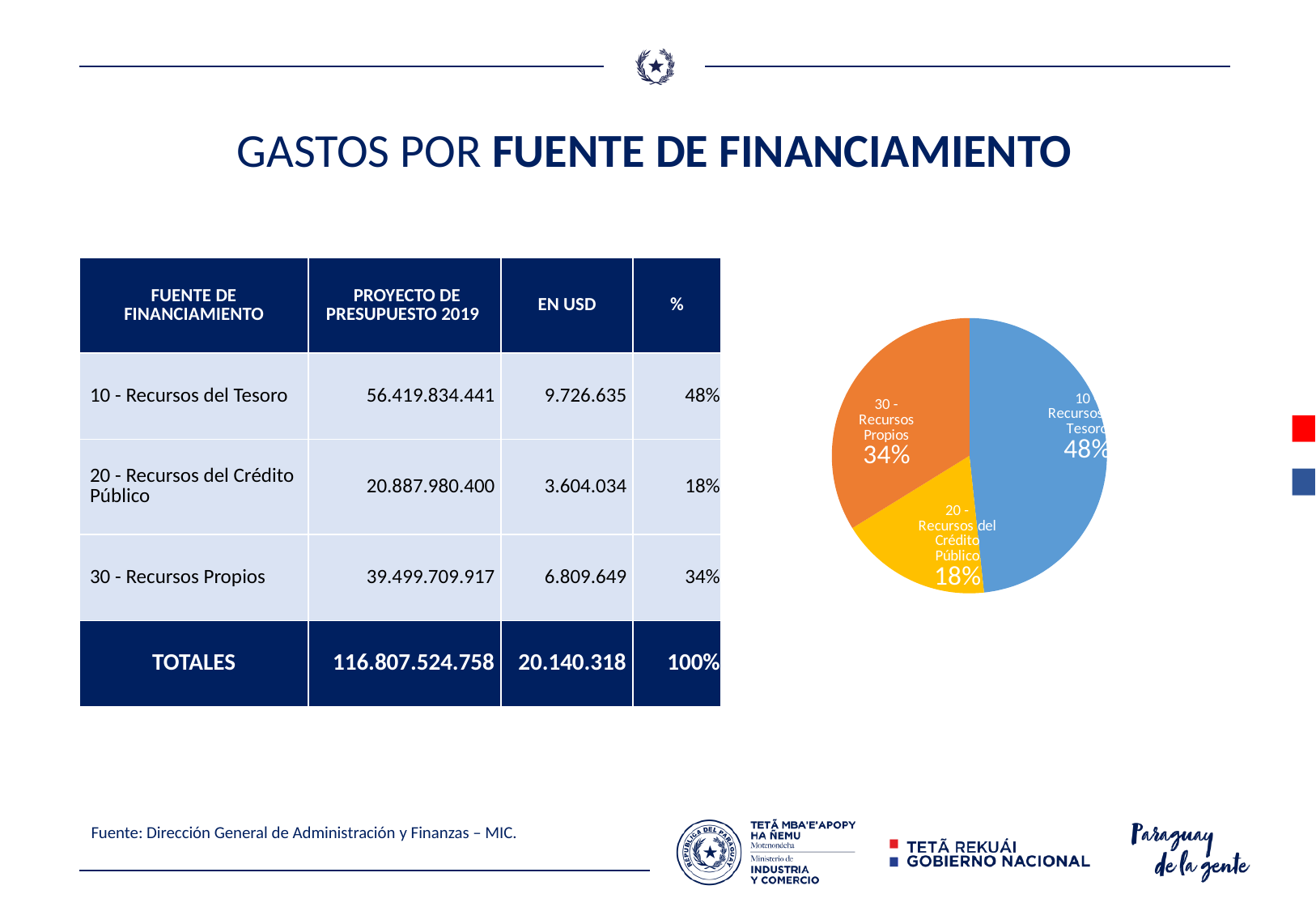
What colour is the "10 - Recursos del Tesoro" slice in the pie chart? blue In the pie chart, which is larger: "30 - Recursos Propios" or "20 - Recursos del Crédito Público"? 30 - Recursos Propios What colour is the "20 - Recursos del Crédito Público" slice in the pie chart? yellow What share of the pie chart does "10 - Recursos del Tesoro" represent? 48% What share of the pie chart does "20 - Recursos del Crédito Público" represent? 18% Which slice of the pie chart is the largest? 10 - Recursos del Tesoro How many slices does the pie chart have? 3 What is the difference in percentage points between the "10 - Recursos del Tesoro" slice and the "30 - Recursos Propios" slice? 14% What share of the pie chart does "30 - Recursos Propios" represent? 34% What kind of chart is shown on the slide? pie chart Which slice of the pie chart is the smallest? 20 - Recursos del Crédito Público What is the difference in percentage points between the "30 - Recursos Propios" slice and the "20 - Recursos del Crédito Público" slice? 16%